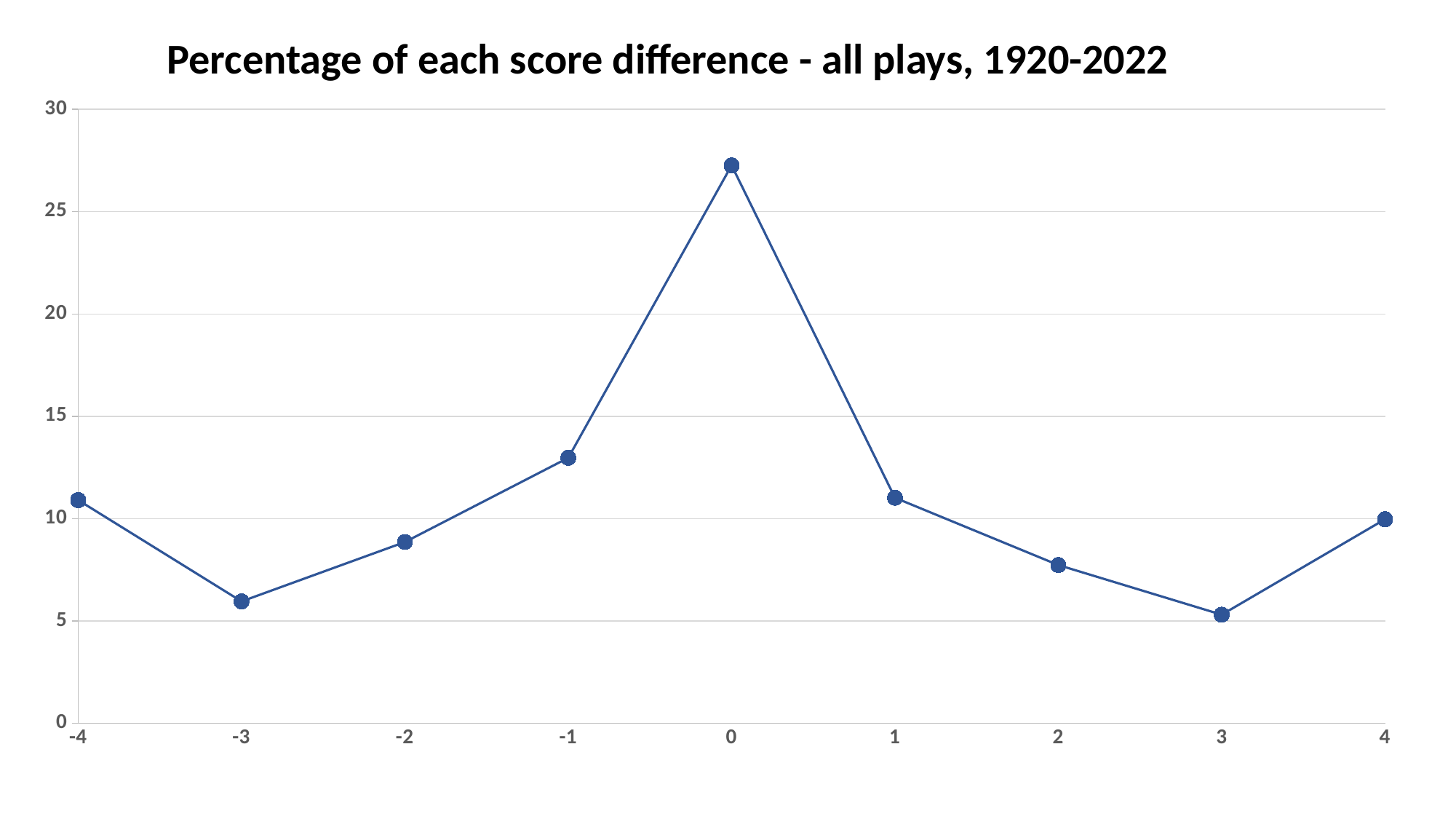
Is the value for score difference 0 greater or less than 25? greater Is the value for score difference 2 greater or less than 10? less Which has a higher value, score difference -1 or score difference 1? -1 Which score difference has the highest percentage? 0 How many data points are plotted on the chart? 9 What kind of chart is shown on the slide? line chart Is the value for score difference -2 greater or less than 10? less Do the values rise or fall from score difference 0 to score difference 3? fall What is the title of the chart? Percentage of each score difference - all plays, 1920-2022 Which has a higher value, score difference -4 or score difference -3? -4